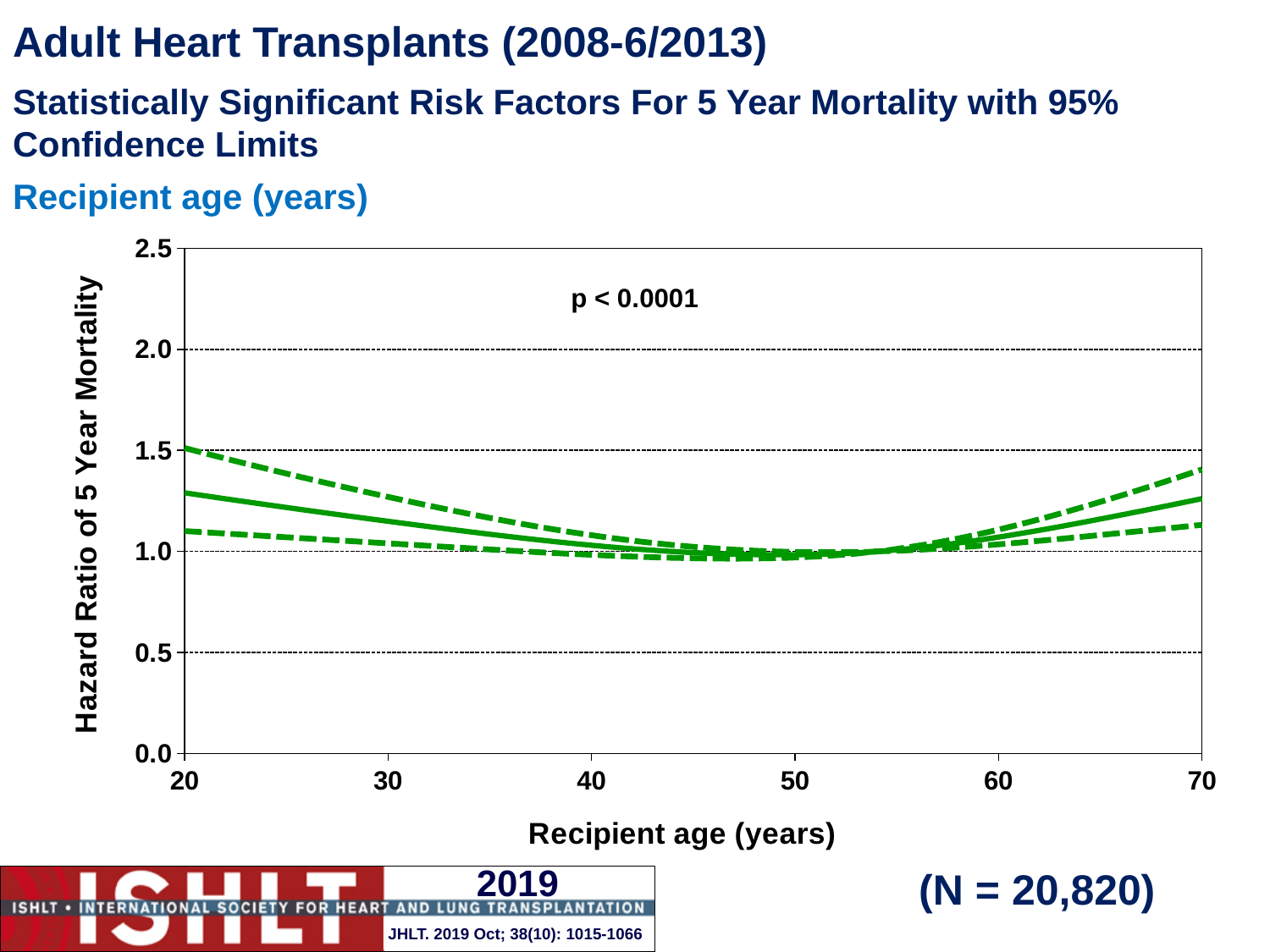
Is the hazard ratio (solid line) at recipient age 20 greater or less than 1.0? greater What is the label of the y axis? Hazard Ratio of 5 Year Mortality Is the upper confidence limit (upper dashed line) at recipient age 70 greater or less than 1.5? less Is the hazard ratio (solid line) at recipient age 70 greater or less than 1.0? greater At which labelled x-axis tick is the hazard ratio (solid line) lowest? 50 Does the hazard ratio rise or fall as recipient age increases from 50 to 70? rise What kind of chart is shown on the slide? line chart Does the hazard ratio rise or fall as recipient age increases from 20 to 50? fall What is the label of the x axis? Recipient age (years) What is the highest value shown on the y axis? 2.5 How many lines are plotted on the chart? 3